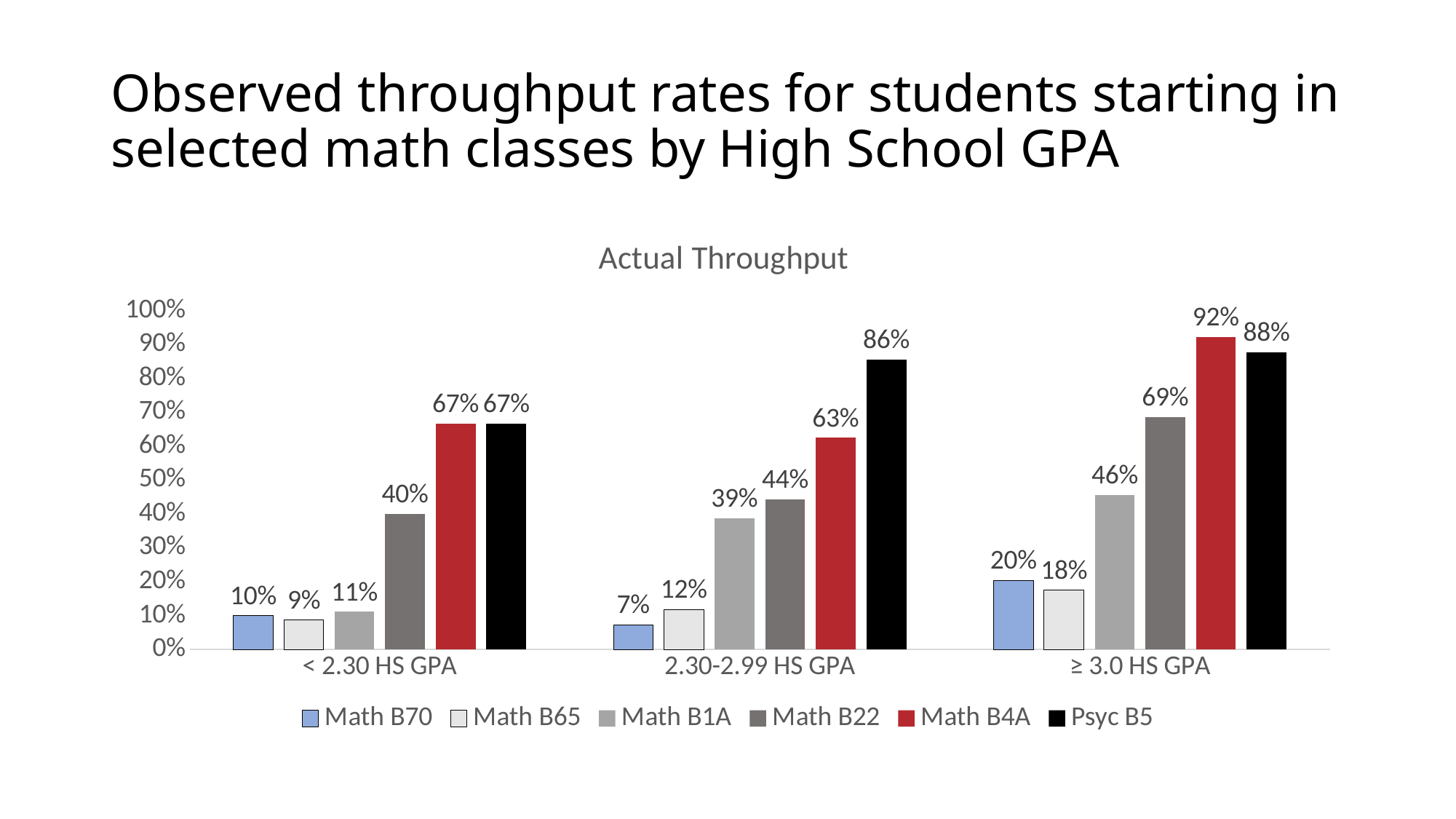
Which series has the highest throughput rate in the 2.30-2.99 HS GPA group? Psyc B5 What is the throughput rate for Math B22 among students with < 2.30 HS GPA? 40% What is the throughput rate for Math B70 among students with 2.30-2.99 HS GPA? 7% What is the difference between the Psyc B5 and Math B22 throughput rates in the 2.30-2.99 HS GPA group? 42% How many series does the legend list? 6 Which is larger: the Math B1A rate for ≥ 3.0 HS GPA or the Math B1A rate for 2.30-2.99 HS GPA? ≥ 3.0 HS GPA What is the title of the chart? Actual Throughput What kind of chart is shown on the slide? Bar chart What is the throughput rate for Math B4A among students with ≥ 3.0 HS GPA? 92% How many HS GPA categories are shown on the x axis? 3 Which series has the lowest throughput rate in the ≥ 3.0 HS GPA group? Math B65